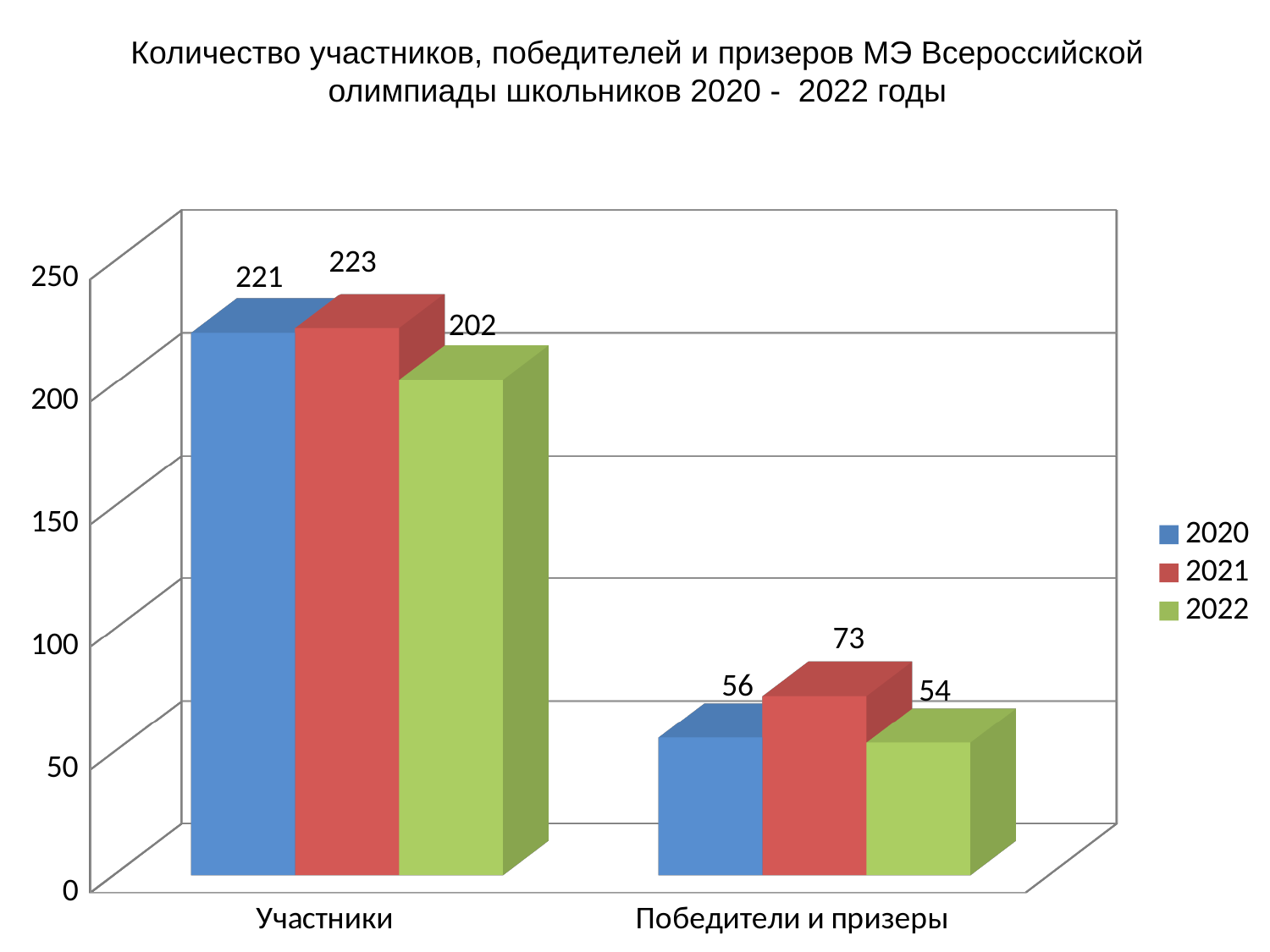
What is the value for 2020 in the Участники category? 221 What is the value for 2021 in the Участники category? 223 Which year has the lowest value in the Участники category? 2022 Which colour represents the 2022 series in the legend? Green What is the value for 2022 in the Победители и призеры category? 54 How many categories are shown on the x axis? 2 Which year has the highest value in the Победители и призеры category? 2021 Which is larger: the 2020 value or the 2022 value in the Победители и призеры category? 2020 How many series does the legend list? 3 What kind of chart is shown on the slide? Bar chart What is the difference between the 2021 and 2022 values in the Участники category? 21 What is the difference between the 2021 and 2020 values in the Победители и призеры category? 17